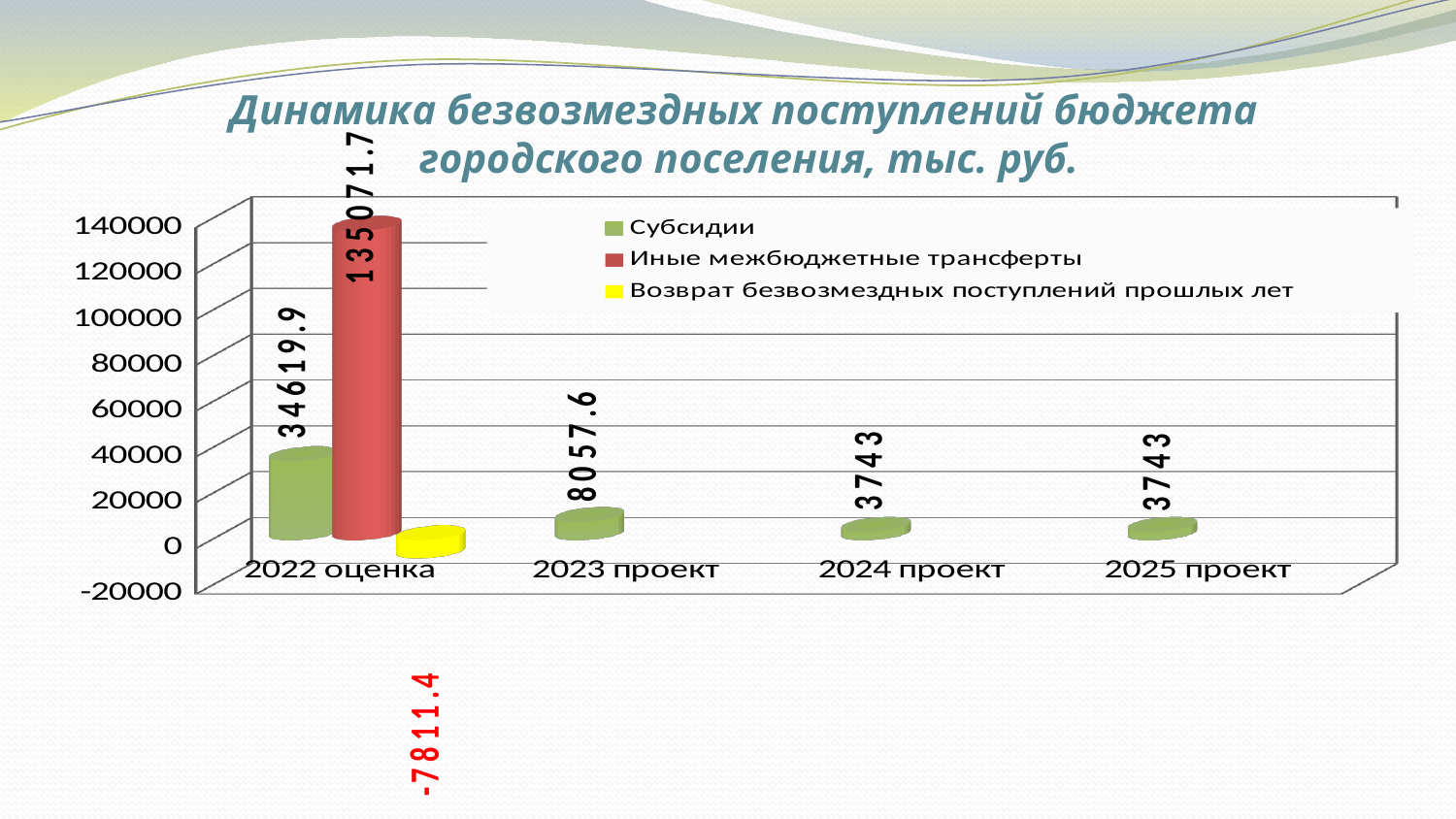
What kind of chart is shown on the slide? bar chart Do the Субсидии values rise or fall from 2022 оценка to 2025 проект? fall How many series does the legend list? 3 How many categories are shown on the x axis? 4 What is the value of Субсидии for 2023 проект? 8057.6 What is the value of Возврат безвозмездных поступлений прошлых лет for 2022 оценка? -7811.4 What is the difference between the Субсидии values for 2022 оценка and 2023 проект? 26562.3 What is the value of Субсидии for 2022 оценка? 34619.9 Which is larger for 2022 оценка: Субсидии or Иные межбюджетные трансферты? Иные межбюджетные трансферты In which year is the Субсидии value highest? 2022 оценка What is the value of Иные межбюджетные трансферты for 2022 оценка? 135071.7 What is the value of Субсидии for 2025 проект? 3743